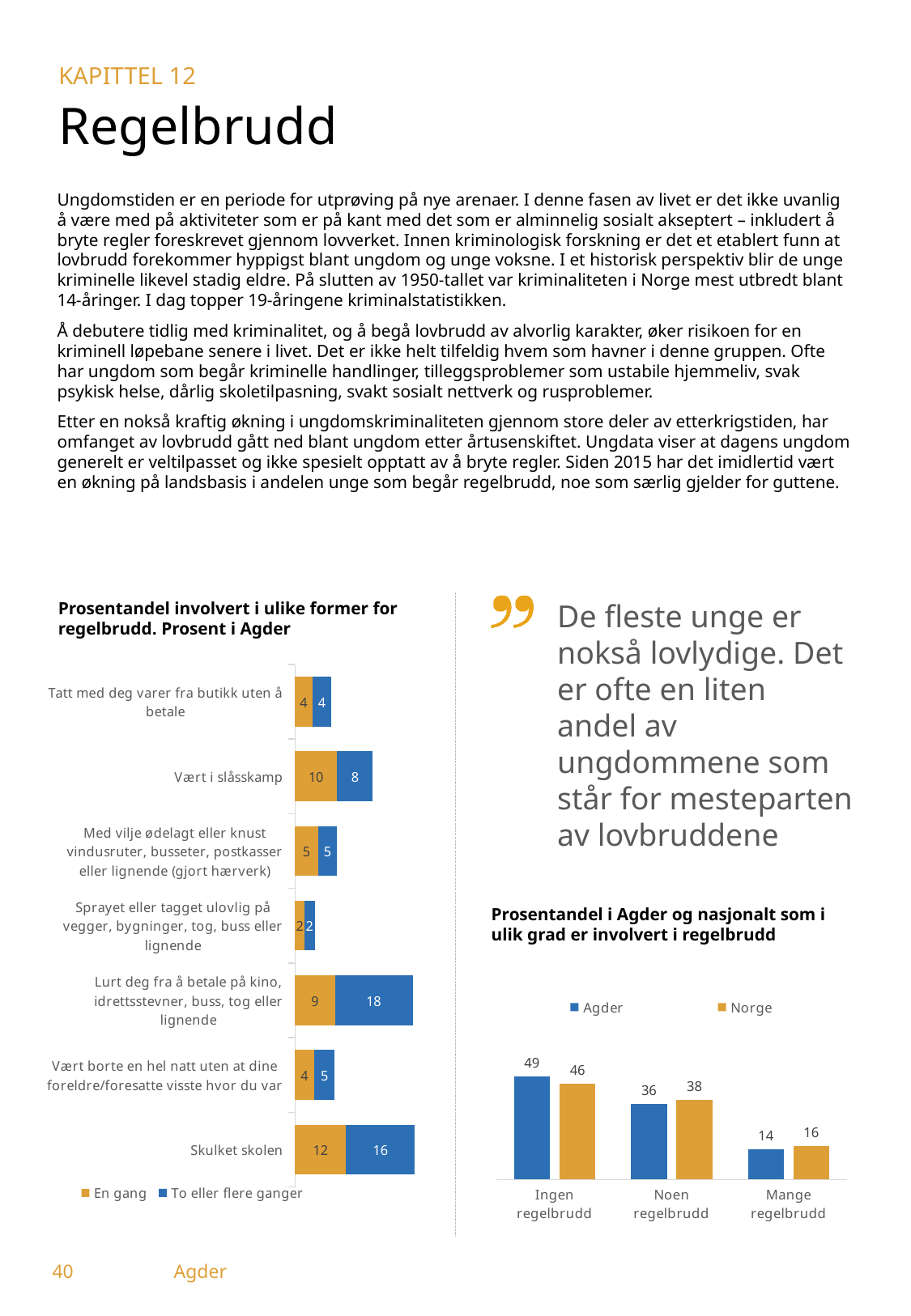
In the chart 'Prosentandel i Agder og nasjonalt som i ulik grad er involvert i regelbrudd', what is the value for Norge in 'Noen regelbrudd'? 38 In the chart 'Prosentandel involvert i ulike former for regelbrudd. Prosent i Agder', what is the value of 'To eller flere ganger' for 'Skulket skolen'? 16 What type of chart is 'Prosentandel i Agder og nasjonalt som i ulik grad er involvert i regelbrudd'? Bar chart In the chart 'Prosentandel involvert i ulike former for regelbrudd. Prosent i Agder', how many categories are shown? 7 In the chart 'Prosentandel involvert i ulike former for regelbrudd. Prosent i Agder', what is the value of 'En gang' for 'Vært i slåsskamp'? 10 In the chart 'Prosentandel i Agder og nasjonalt som i ulik grad er involvert i regelbrudd', what is the difference between Agder and Norge for 'Ingen regelbrudd'? 3 In the chart 'Prosentandel i Agder og nasjonalt som i ulik grad er involvert i regelbrudd', which category has the highest value for Agder? Ingen regelbrudd In the chart 'Prosentandel i Agder og nasjonalt som i ulik grad er involvert i regelbrudd', which is larger for 'Mange regelbrudd', Agder or Norge? Norge In the chart 'Prosentandel involvert i ulike former for regelbrudd. Prosent i Agder', what is the total of the stacked bar for 'Lurt deg fra å betale på kino, idrettsstevner, buss, tog eller lignende'? 27 In the chart 'Prosentandel involvert i ulike former for regelbrudd. Prosent i Agder', how many series does the legend list? 2 In the chart 'Prosentandel involvert i ulike former for regelbrudd. Prosent i Agder', which category has the lowest total? Sprayet eller tagget ulovlig på vegger, bygninger, tog, buss eller lignende In the chart 'Prosentandel involvert i ulike former for regelbrudd. Prosent i Agder', what is the difference between 'To eller flere ganger' and 'En gang' for 'Skulket skolen'? 4